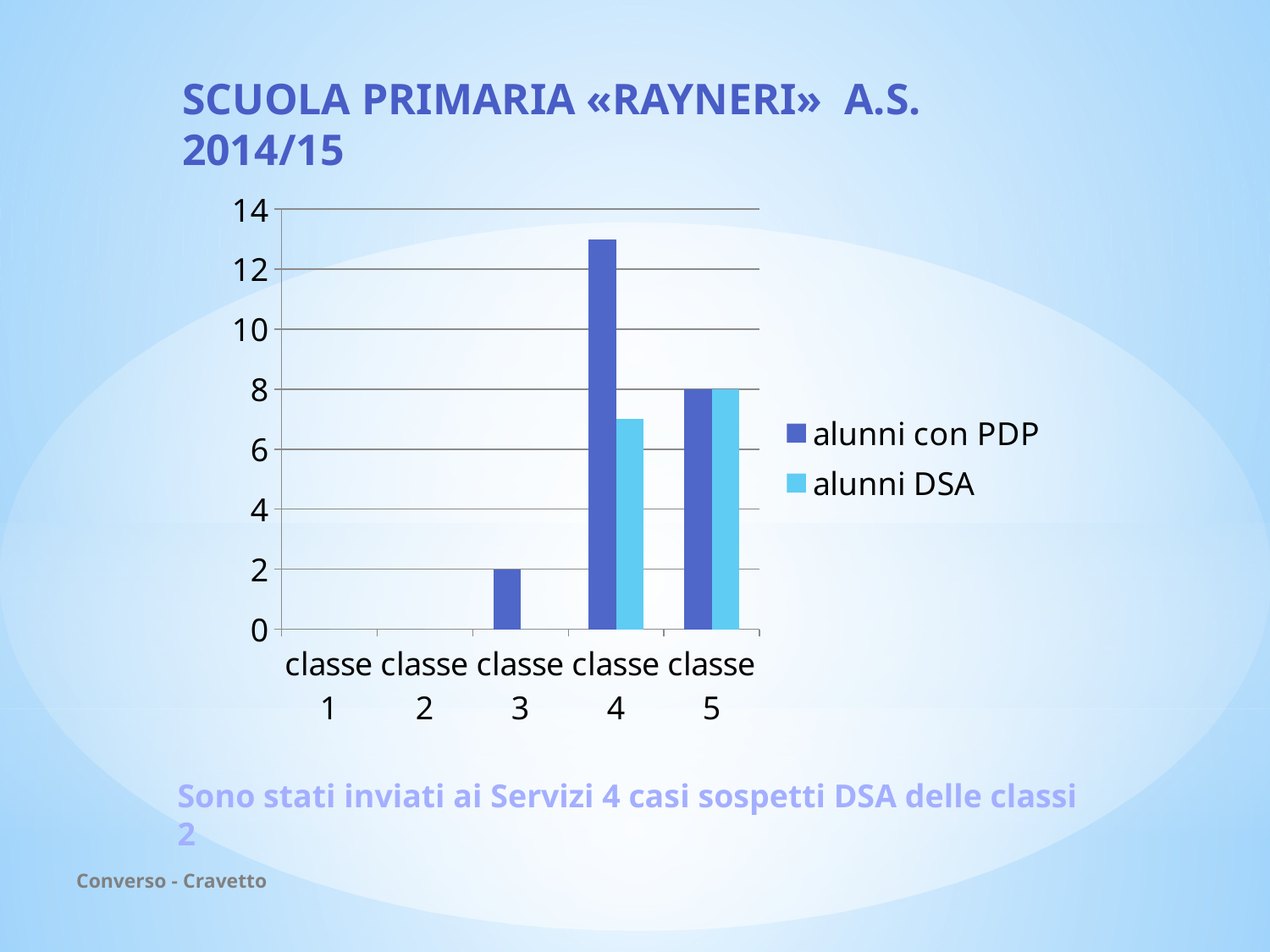
How many series does the legend list? 2 Is the value of 'alunni DSA' for classe 4 greater or less than 8? less What is the difference between 'alunni con PDP' and 'alunni DSA' for classe 5? 0 What is the value of 'alunni con PDP' for classe 5? 8 Is the value of 'alunni con PDP' for classe 4 greater or less than 12? greater How many classes (categories) are shown on the x axis? 5 What kind of chart is shown on the slide? bar chart What are the two series named in the legend? alunni con PDP and alunni DSA Which is larger: 'alunni con PDP' for classe 4 or for classe 5? classe 4 What is the value of 'alunni con PDP' for classe 3? 2 Which class has the highest value for 'alunni con PDP'? classe 4 What is the value of 'alunni DSA' for classe 5? 8